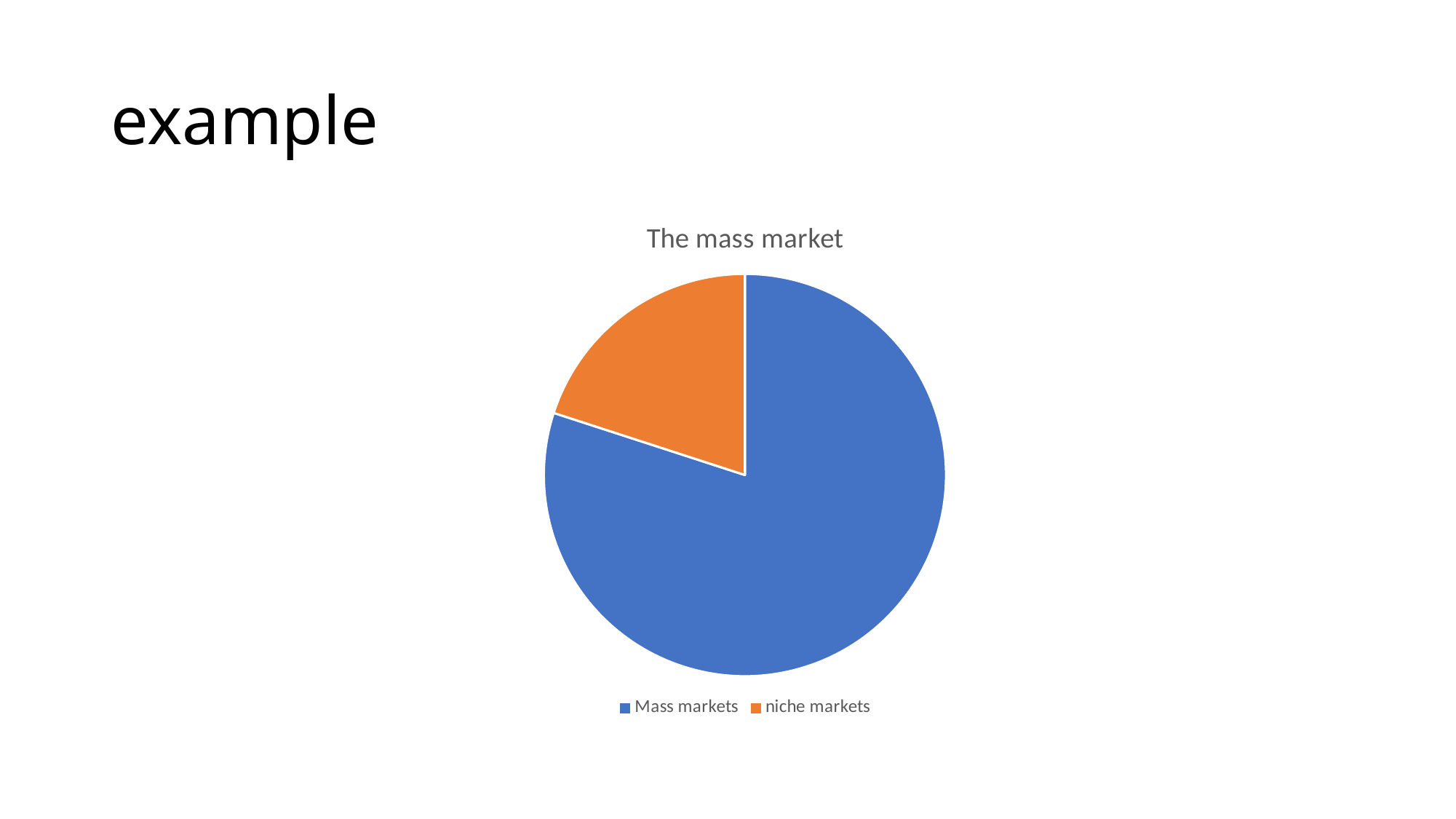
Which slice is larger, Mass markets or niche markets? Mass markets What colour is the Mass markets slice? blue What is the title of the chart? The mass market What kind of chart is shown on the slide? pie chart How many slices does the pie chart have? 2 How many entries does the legend list? 2 Which category has the largest slice of the pie? Mass markets Which category has the smallest slice of the pie? niche markets